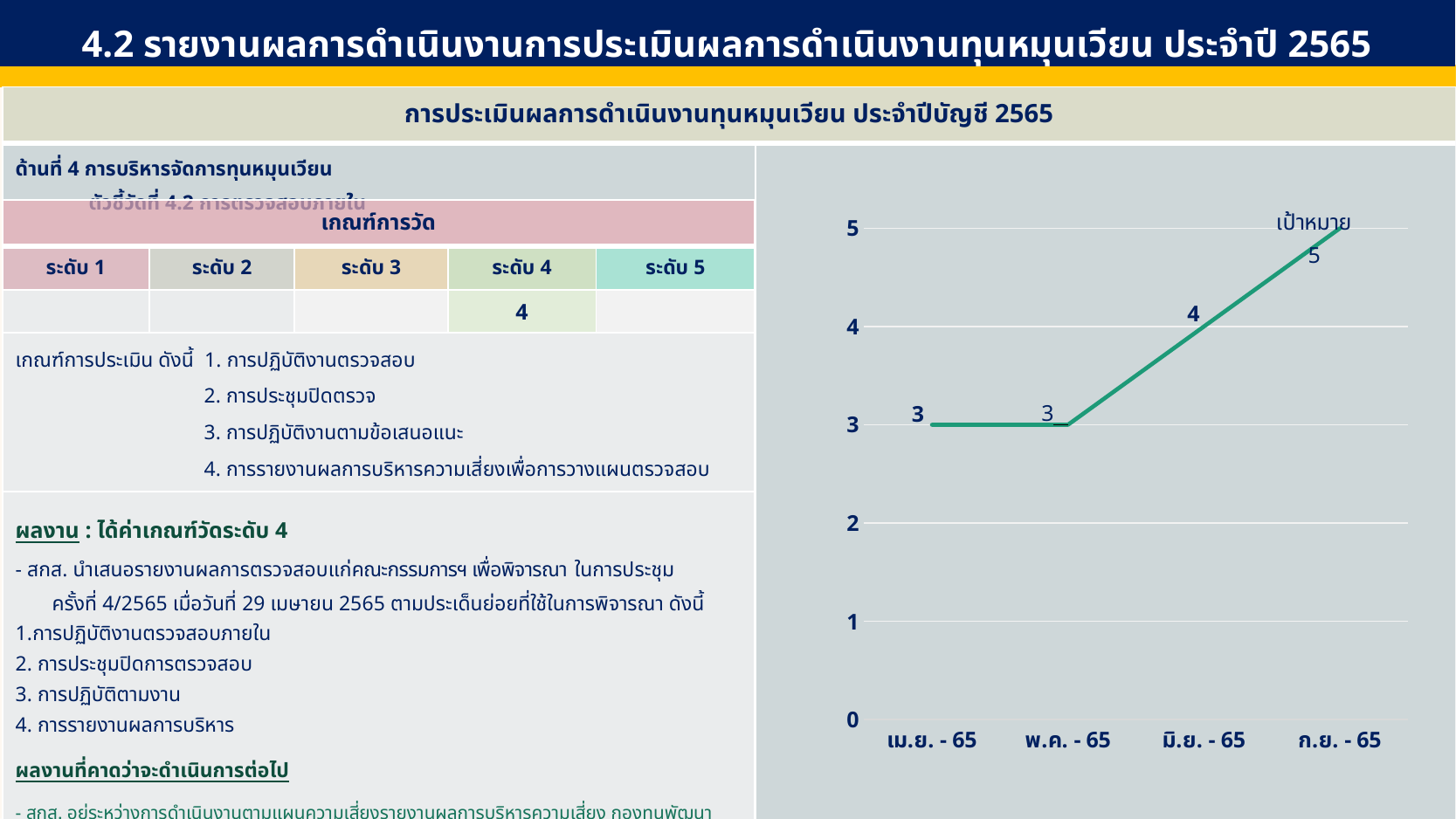
What annotation text is written next to the last point of the line? เป้าหมาย What is the value plotted for พ.ค. - 65? 3 How many categories are shown on the x axis of the chart? 4 What is the difference between the values for ก.ย. - 65 and เม.ย. - 65? 2 What is the value plotted for เม.ย. - 65? 3 What is the value plotted for มิ.ย. - 65? 4 What kind of chart is shown on the right side of the slide? line chart Which category on the x axis has the highest value? ก.ย. - 65 What is the value plotted for ก.ย. - 65? 5 Do the values rise or fall along the x axis from เม.ย. - 65 to ก.ย. - 65? rise What is the highest tick value shown on the y axis of the chart? 5 Which is larger, the value for มิ.ย. - 65 or the value for พ.ค. - 65? มิ.ย. - 65